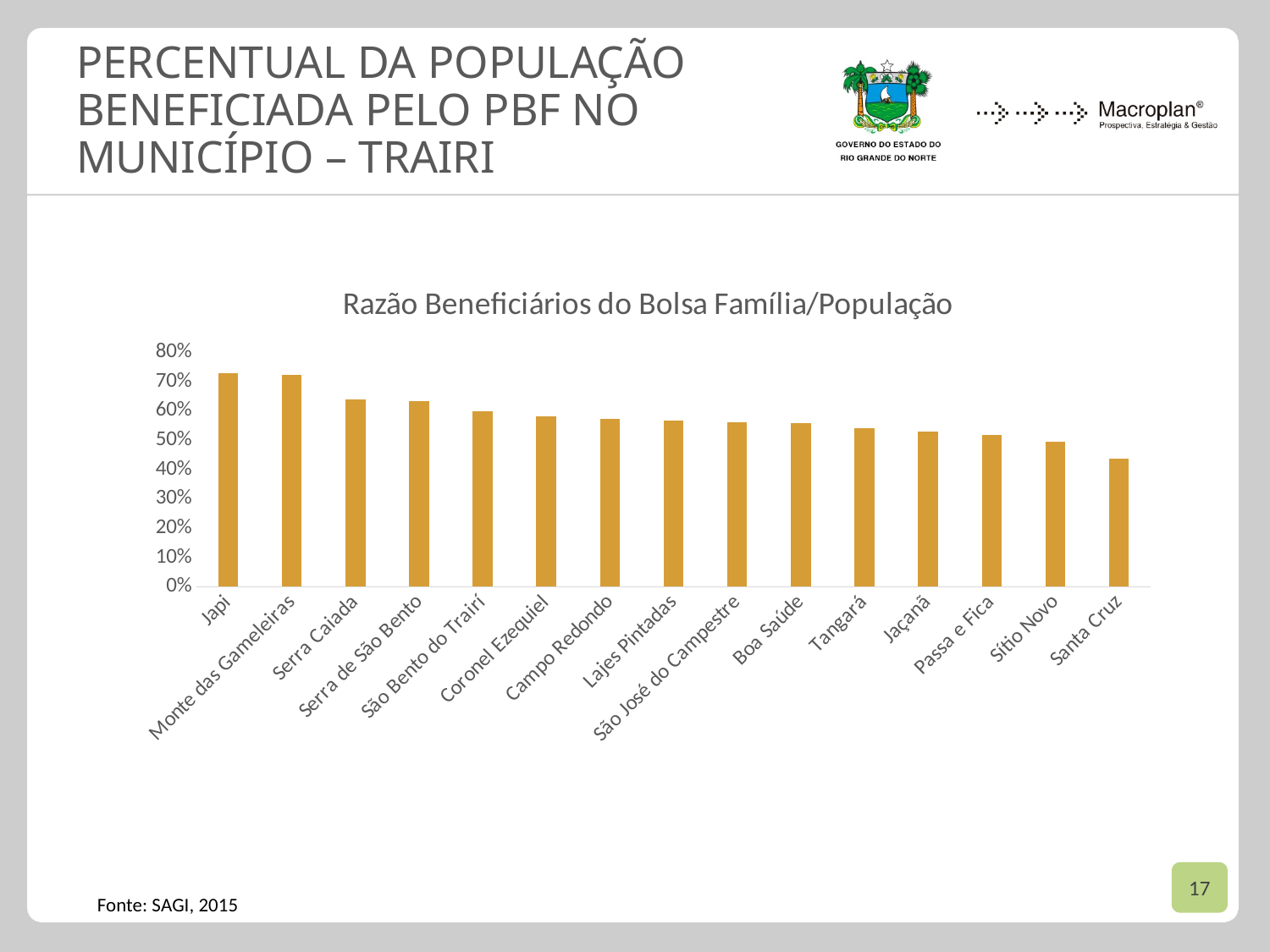
Which has a higher value, Japi or Tangará? Japi Do the values rise or fall moving from left to right along the x axis? Fall How many municipalities are shown on the x axis of the chart? 15 Is the value for Japi greater or less than 70%? greater What is the title of the chart? Razão Beneficiários do Bolsa Família/População Is the value for Serra Caiada greater or less than 60%? greater What kind of chart is shown on the slide? Bar chart Which has a higher value, Serra Caiada or Santa Cruz? Serra Caiada Is the value for Santa Cruz greater or less than 50%? less Which municipality has the lowest ratio of Bolsa Família beneficiaries to population? Santa Cruz